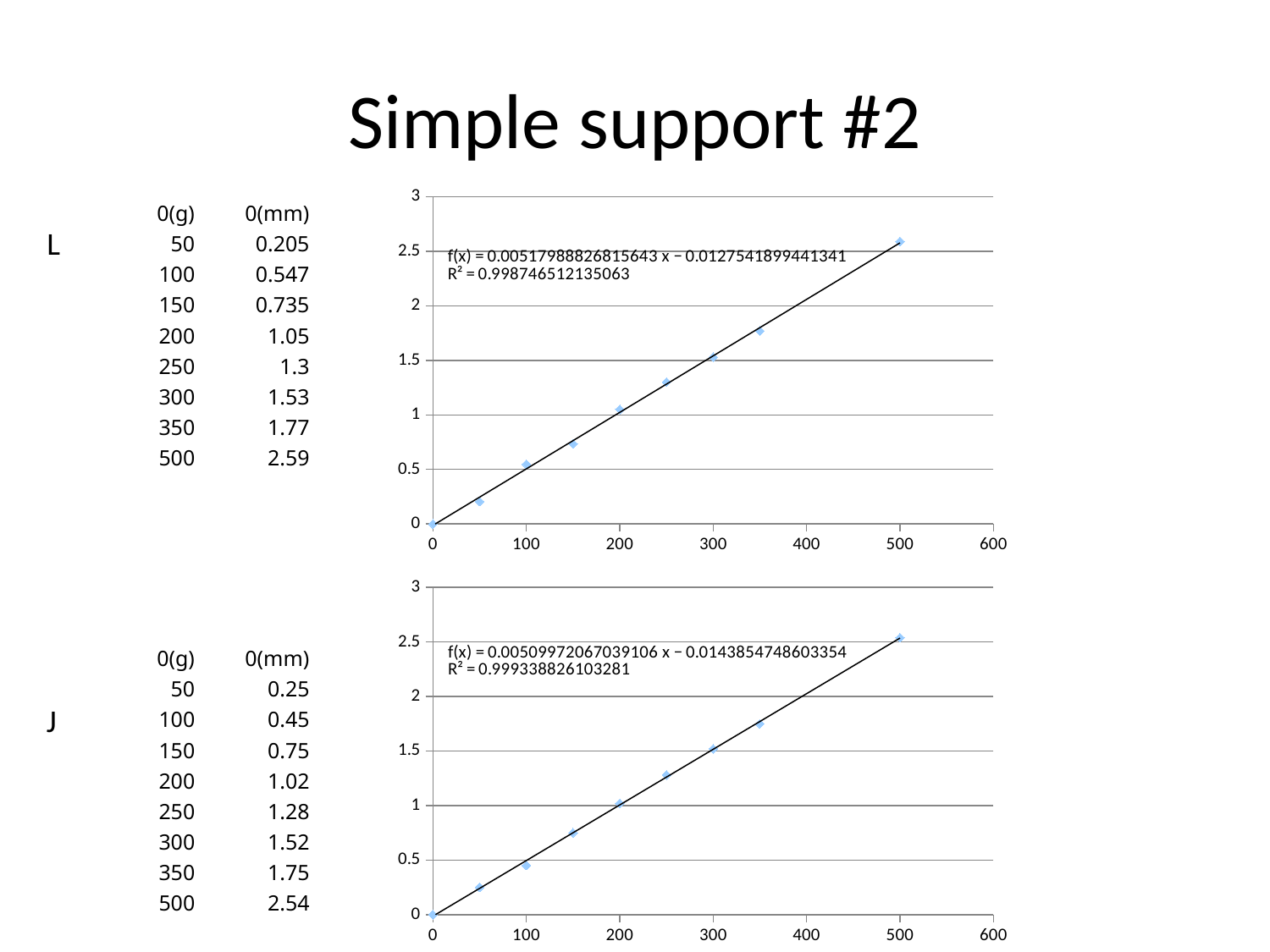
In the bottom chart (J), do the plotted values rise or fall as the x value increases? rise According to the L table, what is the deflection in mm at 300 g? 1.53 In the top chart (L), at which x value is the plotted point highest? 500 According to the J table, what is the deflection in mm at 500 g? 2.54 In the bottom chart (J), is the value at x = 100 greater or less than 0.5? less In the top chart (L), is the value at x = 500 greater or less than 2.5? greater In the top chart (L), is the value at x = 350 greater or less than 1.5? greater What kind of chart is the top chart on the slide? scatter chart with a trendline What R² value is shown on the top chart (L)? 0.998746512135063 In the top chart (L), do the plotted values rise or fall as the x value increases? rise Using the L table, what is the difference between the deflection at 300 g and at 200 g? 0.48 In the bottom chart (J), at which x value is the plotted point highest? 500